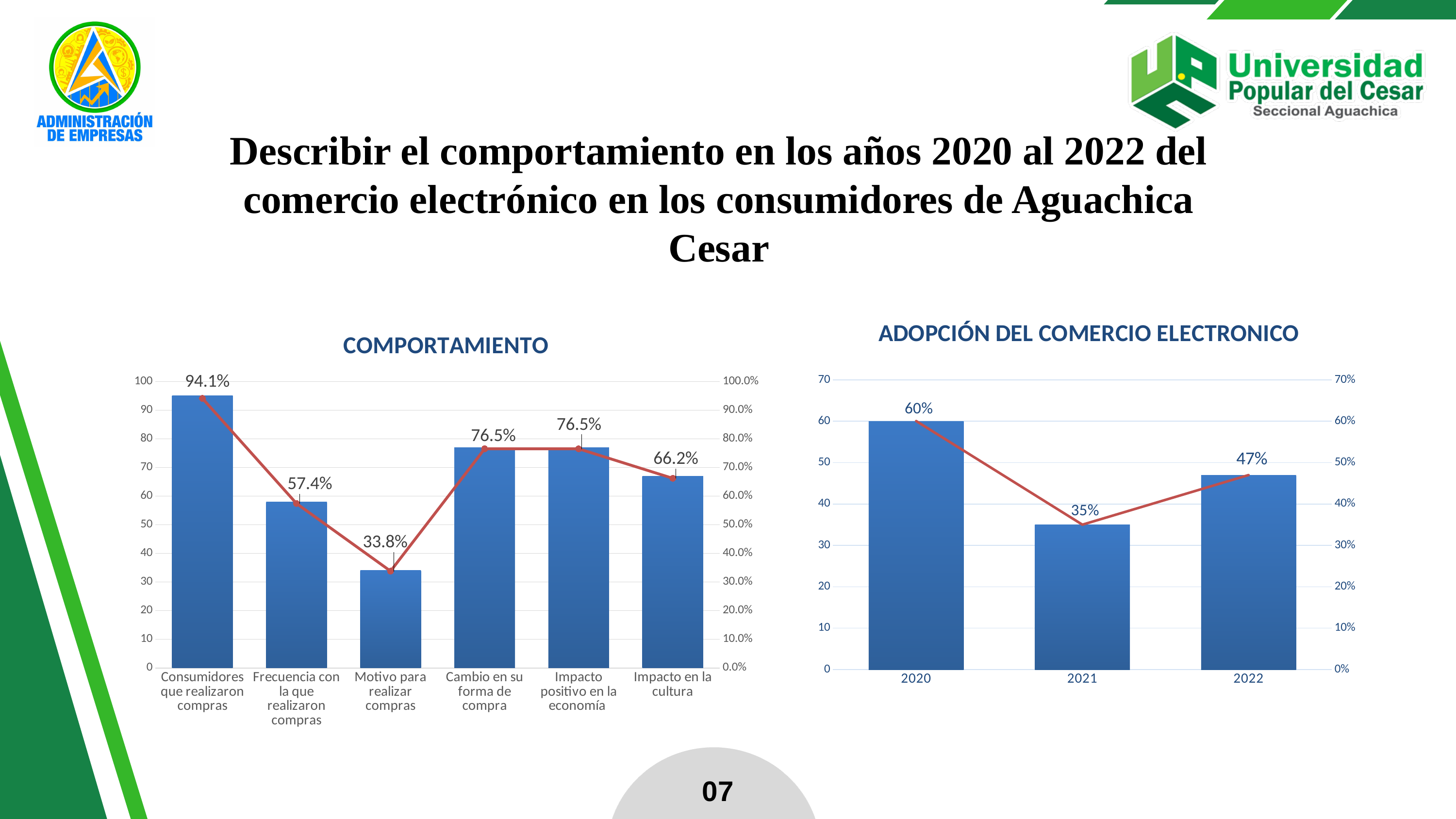
In the ADOPCIÓN DEL COMERCIO ELECTRONICO chart, is the value for 2022 larger or smaller than the value for 2021? larger In the ADOPCIÓN DEL COMERCIO ELECTRONICO chart, how many years are shown on the x axis? 3 In the ADOPCIÓN DEL COMERCIO ELECTRONICO chart, which year has the highest value? 2020 In the COMPORTAMIENTO chart, which category has the highest value? Consumidores que realizaron compras In the ADOPCIÓN DEL COMERCIO ELECTRONICO chart, what is the value for 2021? 35% In the COMPORTAMIENTO chart, which category has the lowest value? Motivo para realizar compras In the COMPORTAMIENTO chart, what is the value for "Impacto en la cultura"? 66.2% What is the title of the chart on the right side of the slide? ADOPCIÓN DEL COMERCIO ELECTRONICO In the COMPORTAMIENTO chart, what is the value for "Motivo para realizar compras"? 33.8% In the ADOPCIÓN DEL COMERCIO ELECTRONICO chart, what is the difference between the 2020 and 2022 values? 13% In the COMPORTAMIENTO chart, how many categories are shown on the x axis? 6 In the COMPORTAMIENTO chart, what is the difference between "Consumidores que realizaron compras" and "Frecuencia con la que realizaron compras"? 36.7%